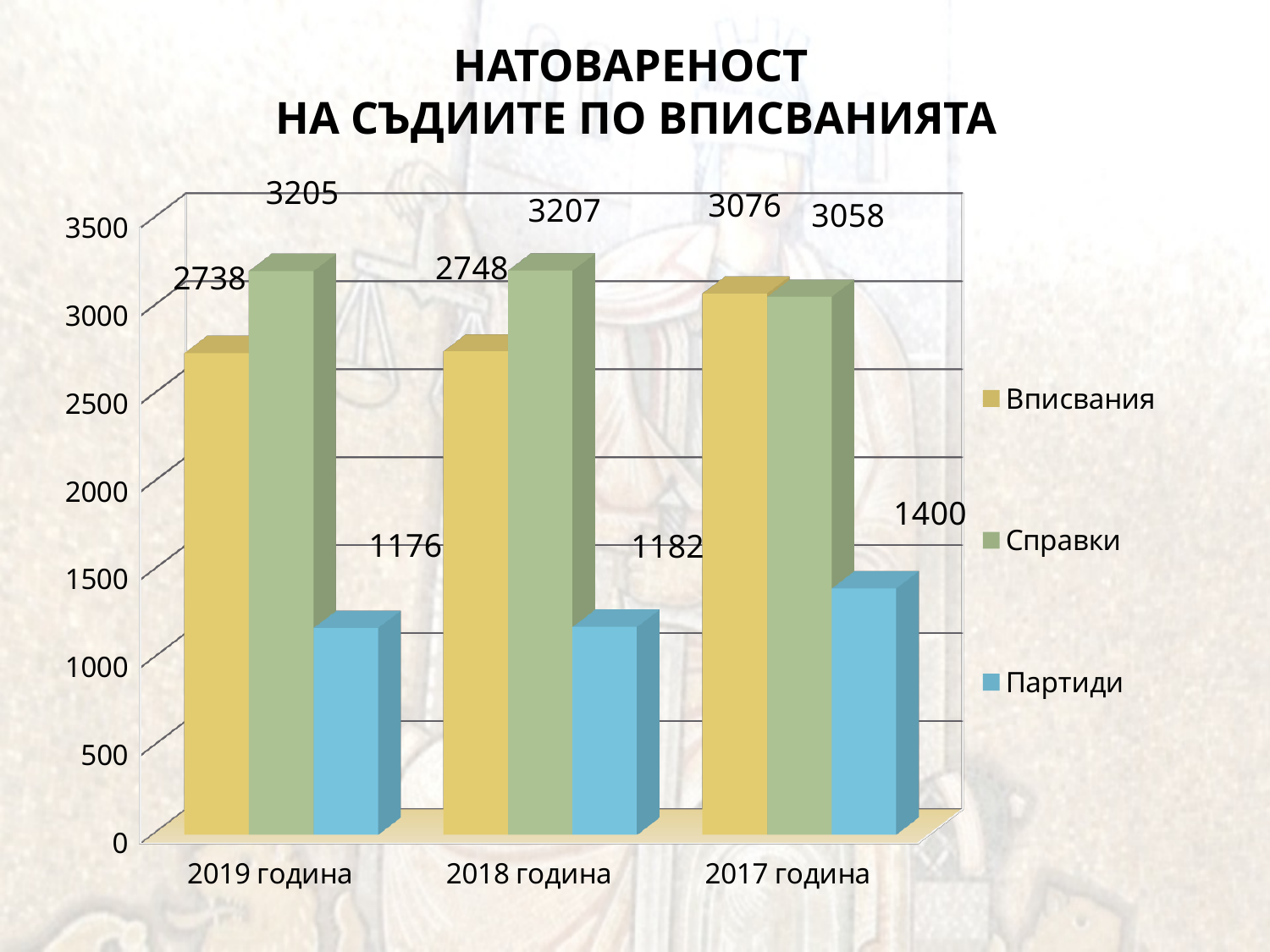
What is the title of the chart? НАТОВАРЕНОСТ НА СЪДИИТЕ ПО ВПИСВАНИЯТА What is the value of Партиди for 2017 година? 1400 What is the difference between Справки and Вписвания for 2019 година? 467 What is the value of Справки for 2018 година? 3207 How many series does the legend list? 3 What is the value of Партиди for 2019 година? 1176 Which year has the lowest value for Партиди? 2019 година Which year has the highest value for Вписвания? 2017 година Which is larger for 2017 година: Вписвания or Справки? Вписвания What is the value of Вписвания for 2019 година? 2738 How many year categories are shown on the x axis? 3 What kind of chart is shown on the slide? Bar chart